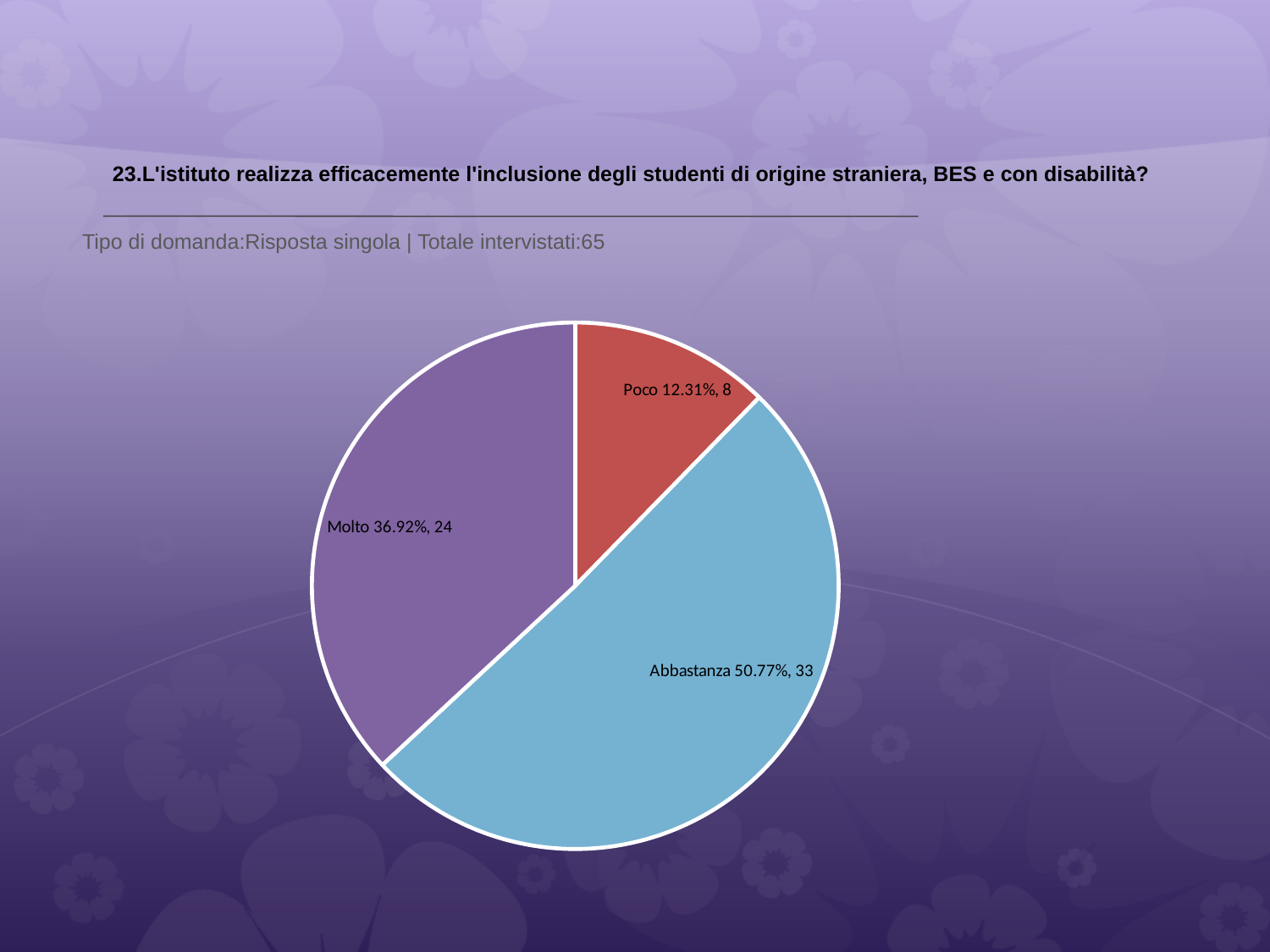
How many respondents answered 'Poco'? 8 What kind of chart is shown on the slide? pie chart How many respondents answered 'Abbastanza'? 33 Which category has the smallest slice? Poco What percentage share does the 'Abbastanza' slice have? 50.77% Which slice is larger, 'Molto' or 'Poco'? Molto What percentage share does the 'Molto' slice have? 36.92% What percentage share does the 'Poco' slice have? 12.31% How many slices does the pie chart have? 3 Which category has the largest slice? Abbastanza What is the difference in respondent count between 'Abbastanza' and 'Molto'? 9 How many respondents answered 'Molto'? 24